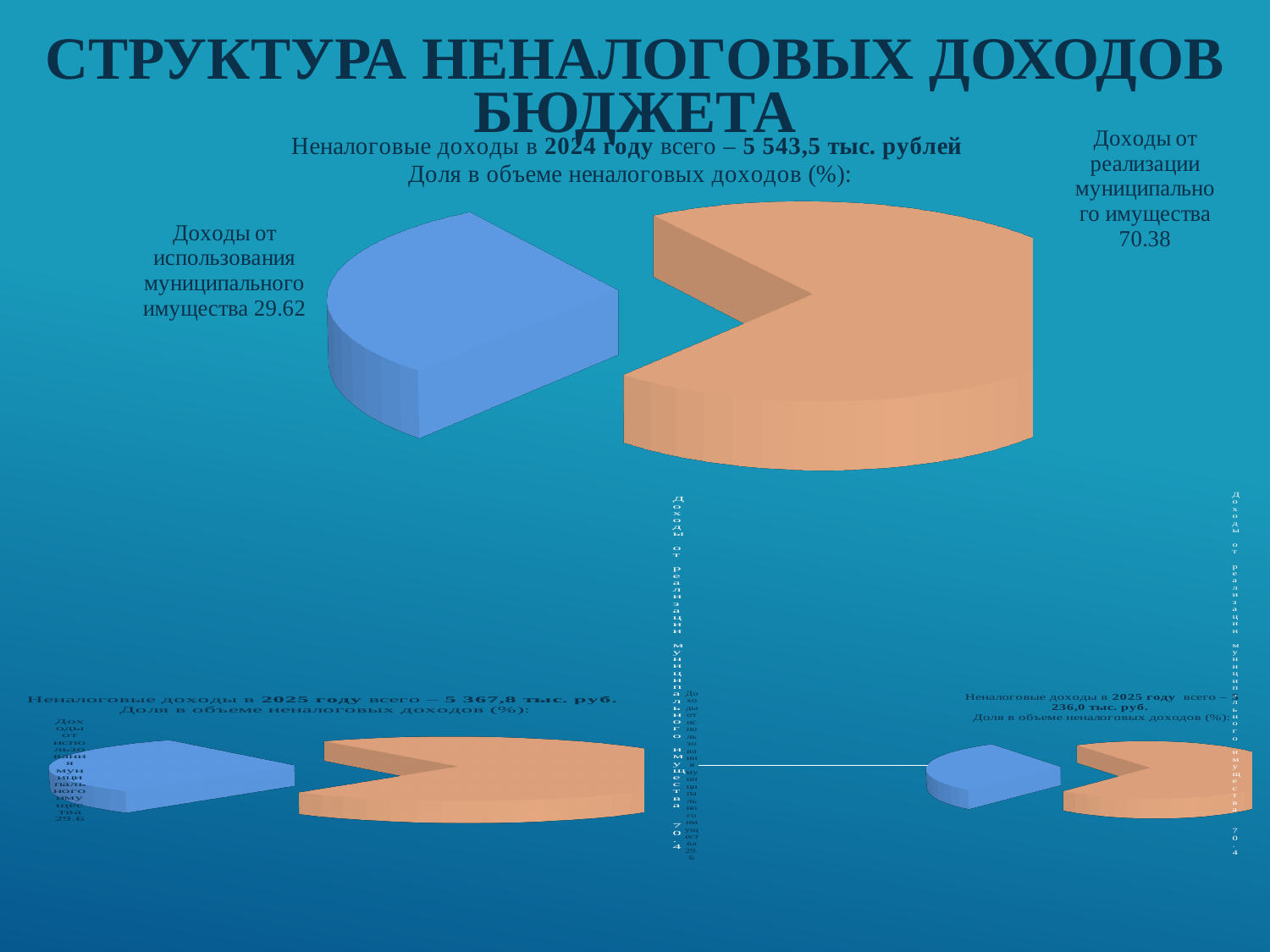
In the top pie chart (2024), which is larger: the share for Доходы от использования муниципального имущества or for Доходы от реализации муниципального имущества? Доходы от реализации муниципального имущества In the top pie chart (2024), which category has the largest share? Доходы от реализации муниципального имущества What type of chart is the top chart on the slide? Pie chart How many slices does the top pie chart (2024) have? 2 In the top pie chart (2024), which category is shown in blue? Доходы от использования муниципального имущества In the top pie chart (2024), what is the difference between the shares of Доходы от реализации муниципального имущества and Доходы от использования муниципального имущества? 40.76 In the top pie chart (2024), which category has the smallest share? Доходы от использования муниципального имущества In the top pie chart (2024), what share is shown for Доходы от реализации муниципального имущества? 70.38 Is the share for Доходы от реализации муниципального имущества in the top pie chart (2024) greater or less than 50? greater According to the text above the top pie chart, what is the total of non-tax revenues in 2024? 5 543,5 тыс. рублей In the top pie chart (2024), what share is shown for Доходы от использования муниципального имущества? 29.62 How many pie charts are shown on the slide? 3